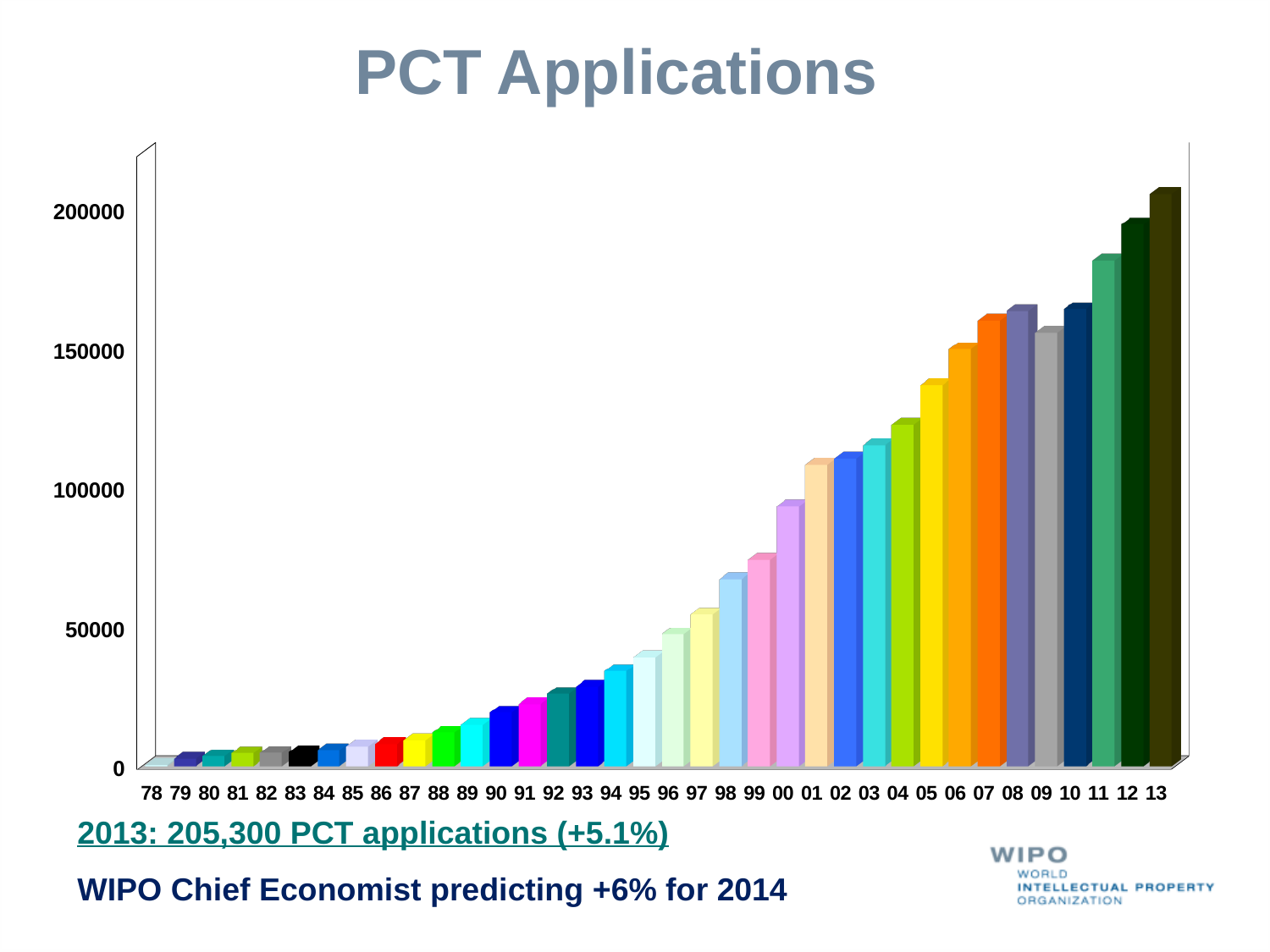
Is the value for 13 greater or less than 200000? greater Which year has the highest number of PCT applications? 13 Which year has the lowest number of PCT applications? 78 Is the value for 11 greater or less than 200000? less Is the value for 05 greater or less than 150000? less What kind of chart is shown on the slide? bar chart Do the values generally rise or fall from 78 to 13? rise What is the title of the chart? PCT Applications According to the slide, how many PCT applications were there in 2013? 205,300 Which year has more PCT applications, 08 or 09? 08 How many years (bars) are plotted on the chart? 36